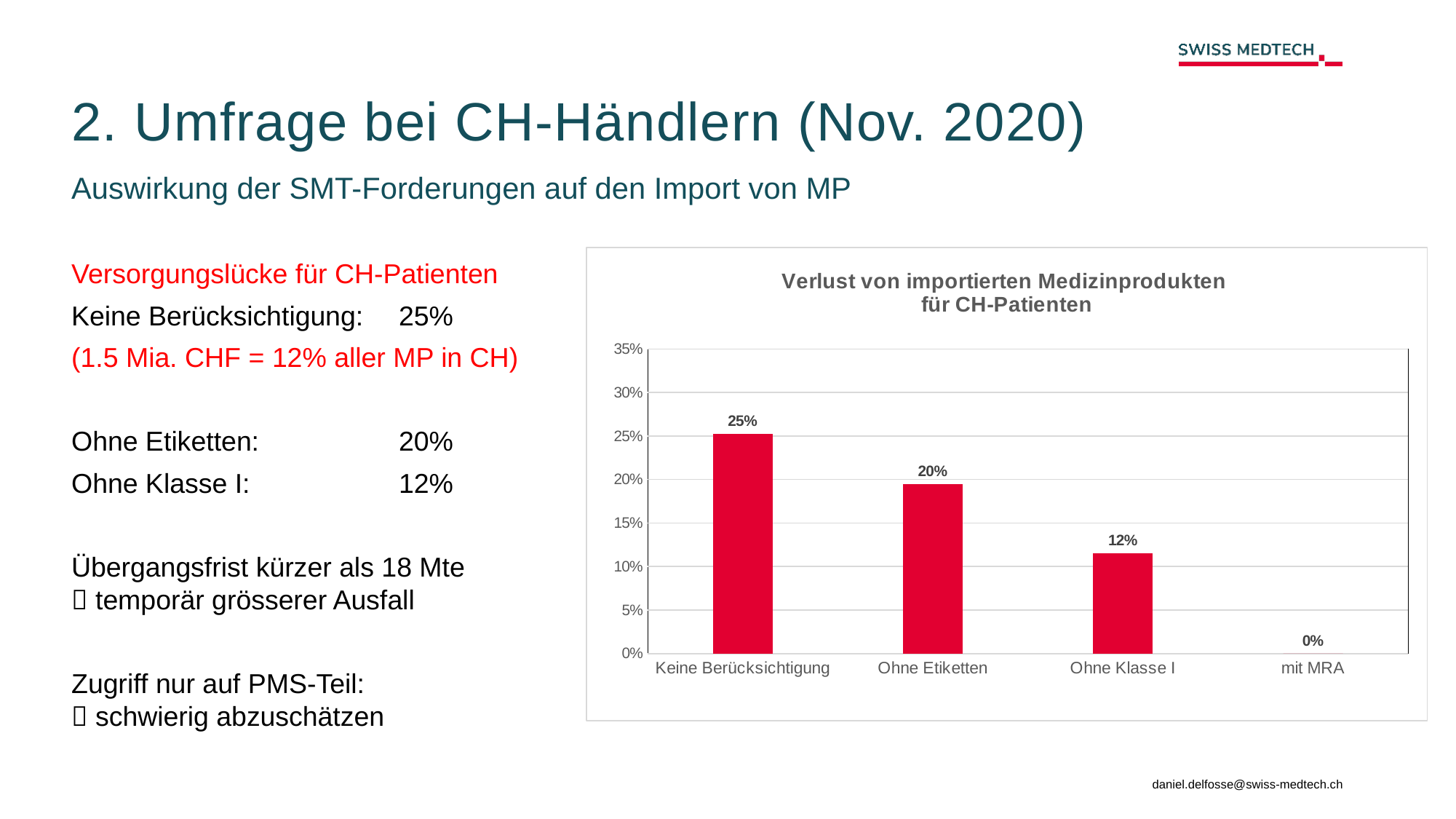
Is the value for Ohne Etiketten greater or less than 15%? greater How many categories are shown on the x axis? 4 What is the value for mit MRA? 0% What is the title of the chart? Verlust von importierten Medizinprodukten für CH-Patienten What is the value for Ohne Etiketten? 20% What is the difference between the values for Keine Berücksichtigung and Ohne Klasse I? 13% What is the value for Ohne Klasse I? 12% Which is larger, the value for Ohne Etiketten or the value for Ohne Klasse I? Ohne Etiketten What is the value for Keine Berücksichtigung? 25% Which category has the highest value? Keine Berücksichtigung What kind of chart is shown on the slide? bar chart Which category has the lowest value? mit MRA